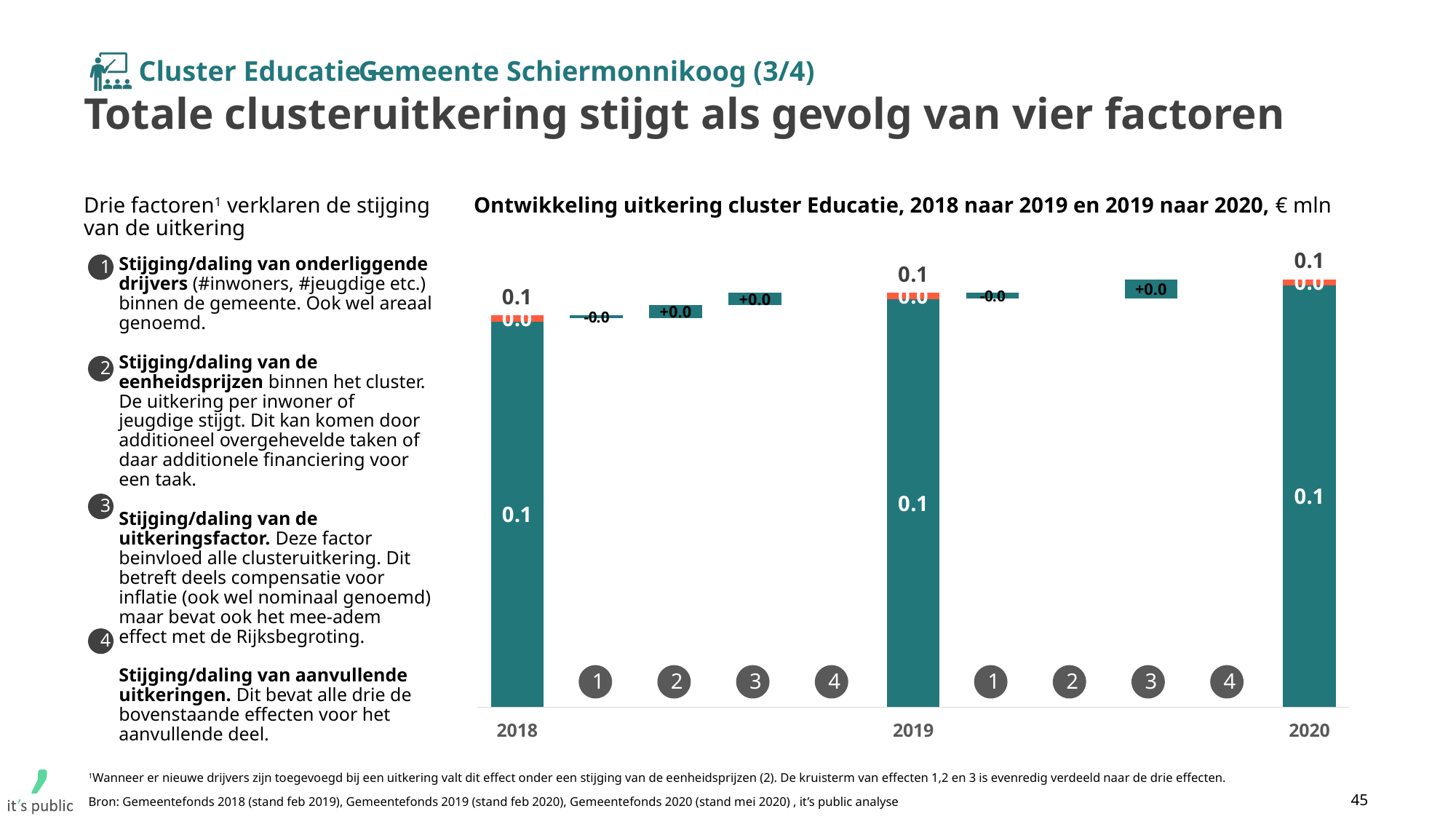
What value is labelled on factor 1 between 2018 and 2019? -0.0 What value is labelled on factor 2 between 2018 and 2019? +0.0 What is the title of the chart? Ontwikkeling uitkering cluster Educatie, 2018 naar 2019 en 2019 naar 2020 In what unit are the values in the chart expressed? € mln What kind of chart is shown on the slide? Bar chart (waterfall) What is the value of the large teal segment of the 2020 bar? 0.1 What value is labelled on factor 3 between 2019 and 2020? +0.0 What is the total value shown above the 2019 bar? 0.1 What is the total value shown above the 2018 bar? 0.1 How many years are shown as total bars on the x axis? 3 What is the total value shown above the 2020 bar? 0.1